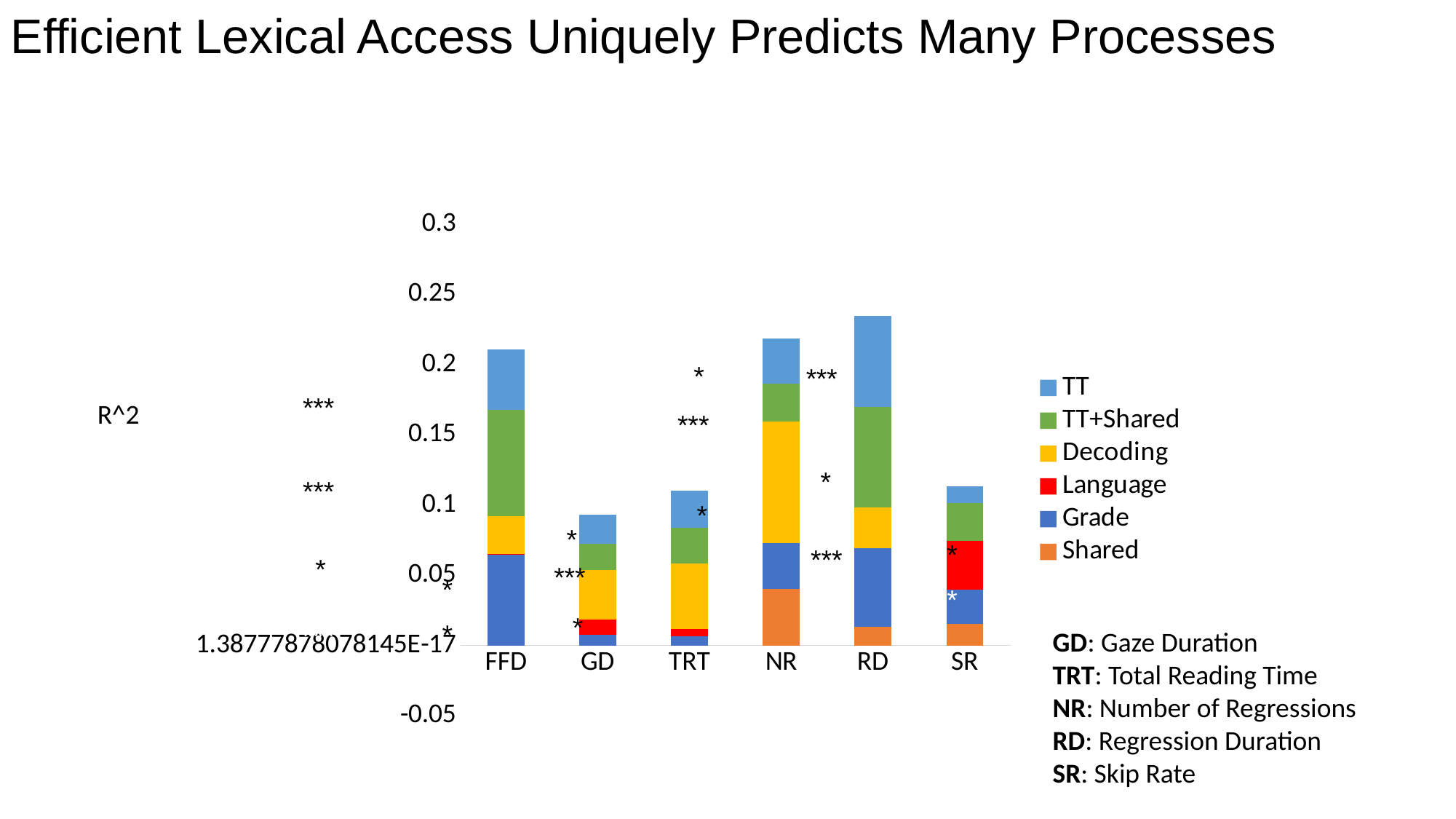
Which has the taller stacked bar, RD or GD? RD Which category has the shortest stacked bar? GD What kind of chart is shown on the slide? stacked bar chart Is the total stacked value for NR greater or less than 0.2? greater What label is shown on the vertical axis of the chart? R^2 Is the total stacked value for SR greater or less than 0.15? less How many series does the chart's legend list? 6 Which category has the tallest stacked bar? RD Is the total stacked value for FFD greater or less than 0.15? greater How many categories are shown along the x axis of the chart? 6 Which colour represents the Language series in the legend? red